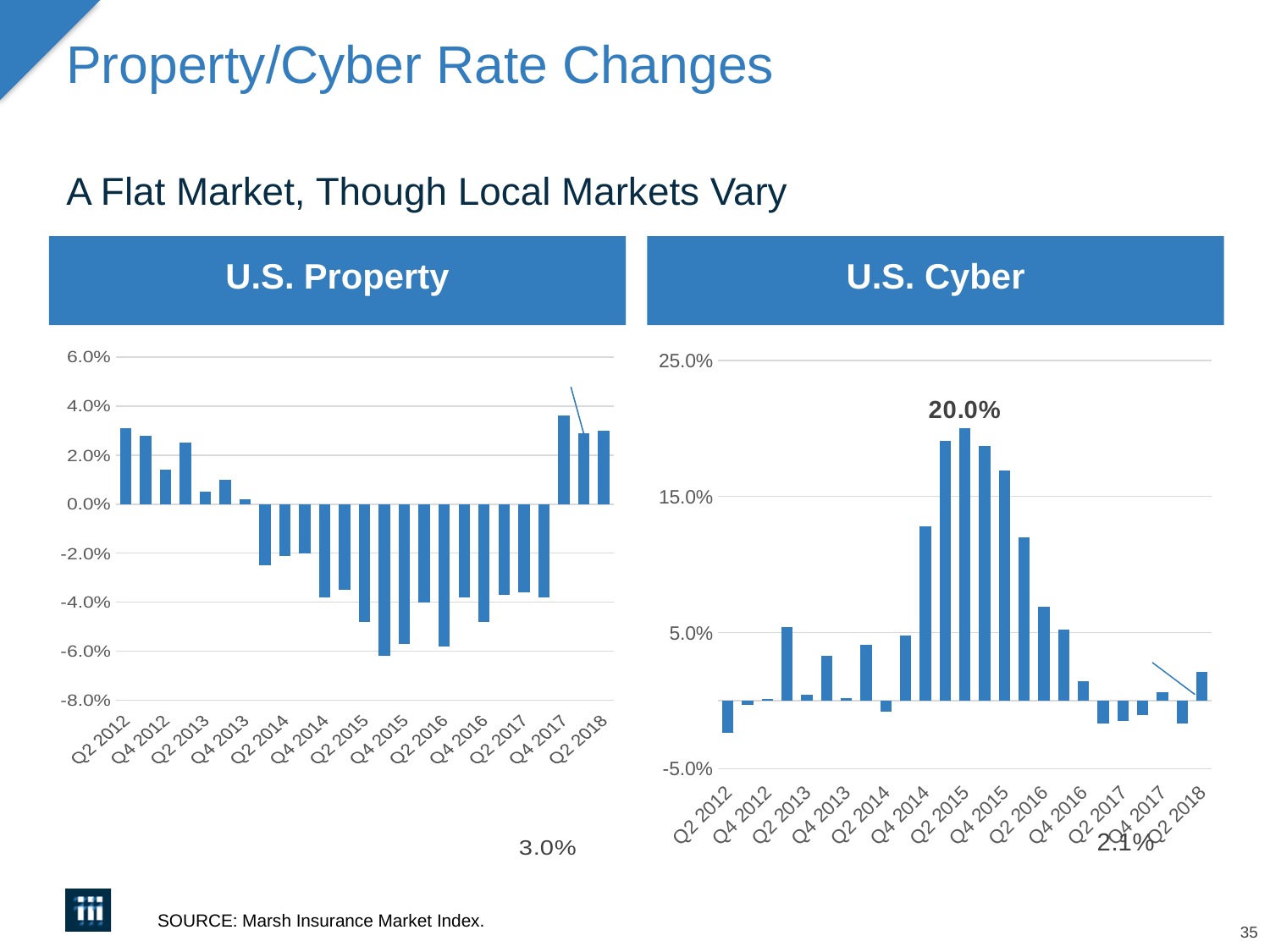
In the U.S. Cyber chart, do the values rise or fall from Q2 2015 to Q2 2016? fall In the U.S. Cyber chart, what is the labelled peak value? 20.0% What is the highest value shown on the y axis of the U.S. Cyber chart? 25.0% In the U.S. Property chart, which is larger, the value for Q2 2012 or the value for Q2 2013? Q2 2012 In the U.S. Cyber chart, which is larger, the value for Q2 2015 or the value for Q2 2018? Q2 2015 In the U.S. Cyber chart, is the value for Q4 2014 greater or less than 10.0%? greater In the U.S. Cyber chart, what is the labelled value for Q2 2018? 2.1% What is the title of the chart on the right side of the slide? U.S. Cyber What type of chart is the U.S. Property chart? bar chart In the U.S. Cyber chart, which quarter has the highest rate change? Q2 2015 In the U.S. Property chart, is the value for Q2 2012 greater or less than 2.0%? greater In the U.S. Property chart, is the value for Q2 2016 greater or less than -4.0%? less